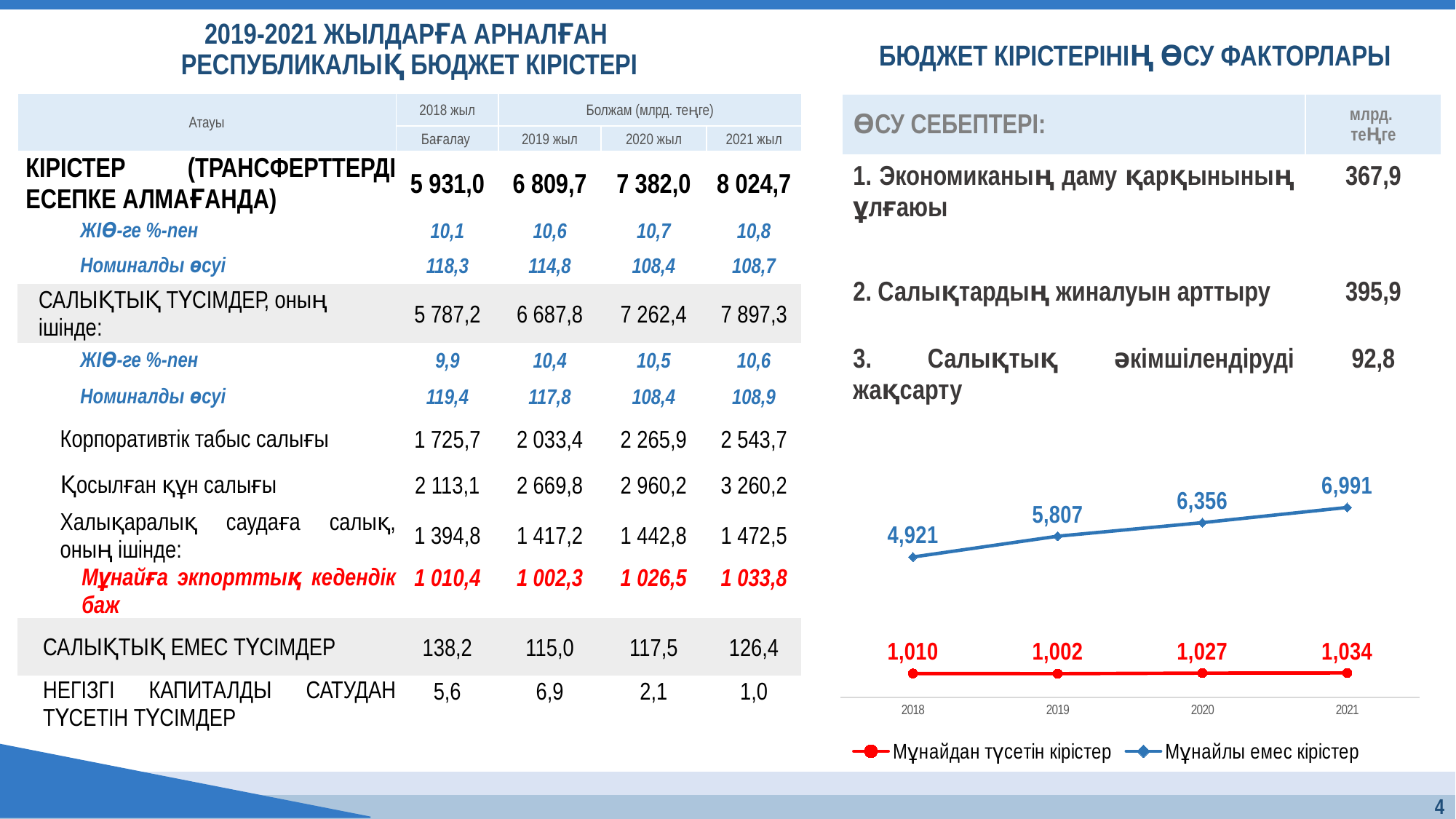
In the line chart on the right, what is the value of Мұнайлы емес кірістер for 2021? 6,991 How many years are plotted on the x axis of the line chart on the right? 4 In the line chart on the right, which year has the highest value for Мұнайлы емес кірістер? 2021 In the line chart on the right, what is the difference between Мұнайлы емес кірістер and Мұнайдан түсетін кірістер in 2021? 5,957 In the line chart on the right, which year has the lowest value for Мұнайдан түсетін кірістер? 2019 In the line chart on the right, what is the value of Мұнайдан түсетін кірістер for 2019? 1,002 What kind of chart is shown on the right side of the slide? line chart In the line chart on the right, what is the value of Мұнайлы емес кірістер for 2018? 4,921 In the line chart on the right, which series has the larger value in 2020, Мұнайдан түсетін кірістер or Мұнайлы емес кірістер? Мұнайлы емес кірістер In the line chart on the right, does the Мұнайлы емес кірістер series rise or fall from 2018 to 2021? rise In the line chart on the right, what is the difference between the Мұнайлы емес кірістер values for 2021 and 2018? 2,070 How many series does the legend of the line chart on the right list? 2